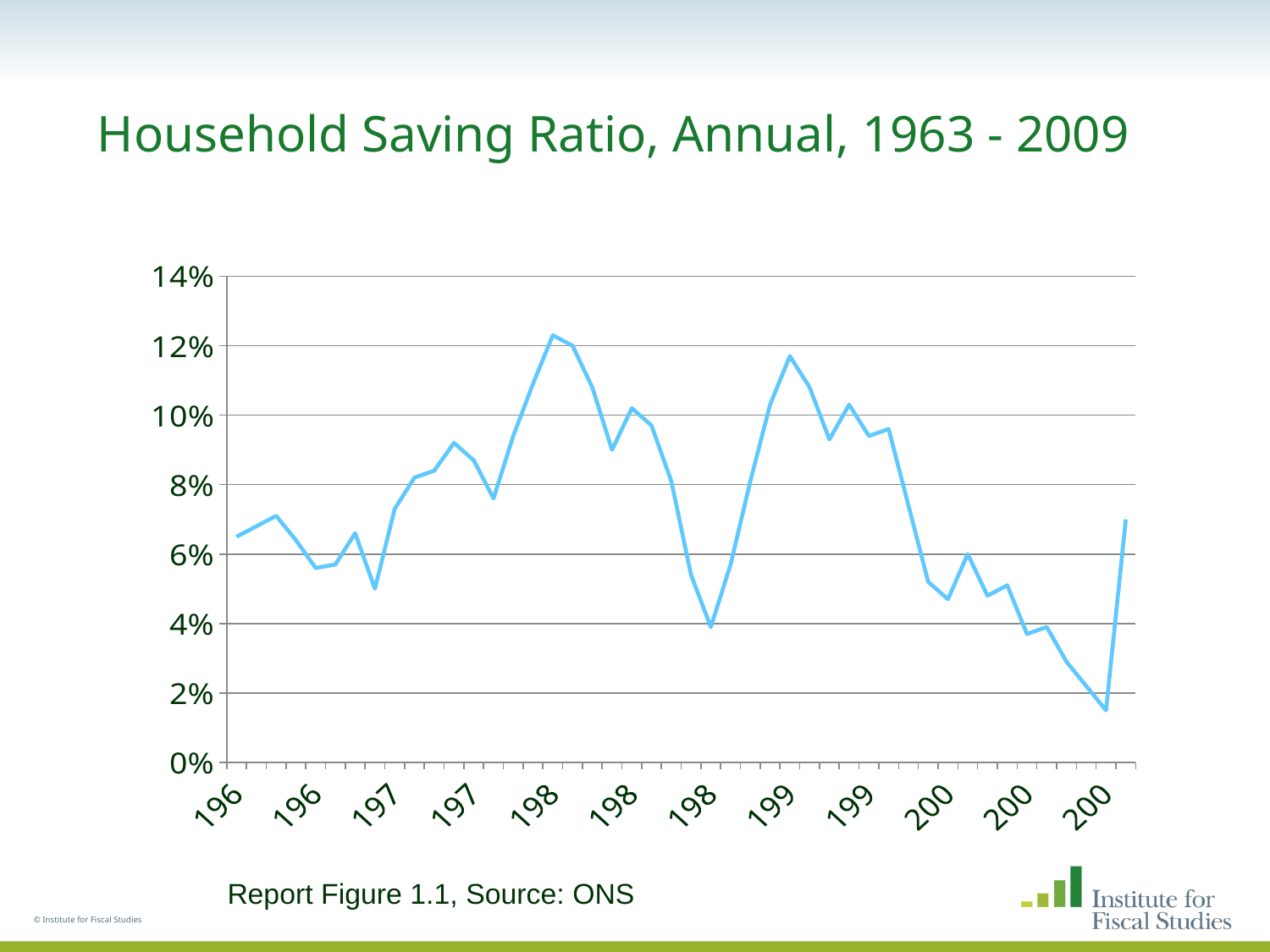
Is the lowest point on the line greater or less than 4%? less Does the line ever fall below 0% on the chart? no Does the line ever rise above 12% on the chart? yes What kind of chart is shown on the slide? line chart What source is cited below the chart? Report Figure 1.1, Source: ONS What is the title of the chart? Household Saving Ratio, Annual, 1963 - 2009 What is the highest value shown on the vertical axis of the chart? 14%